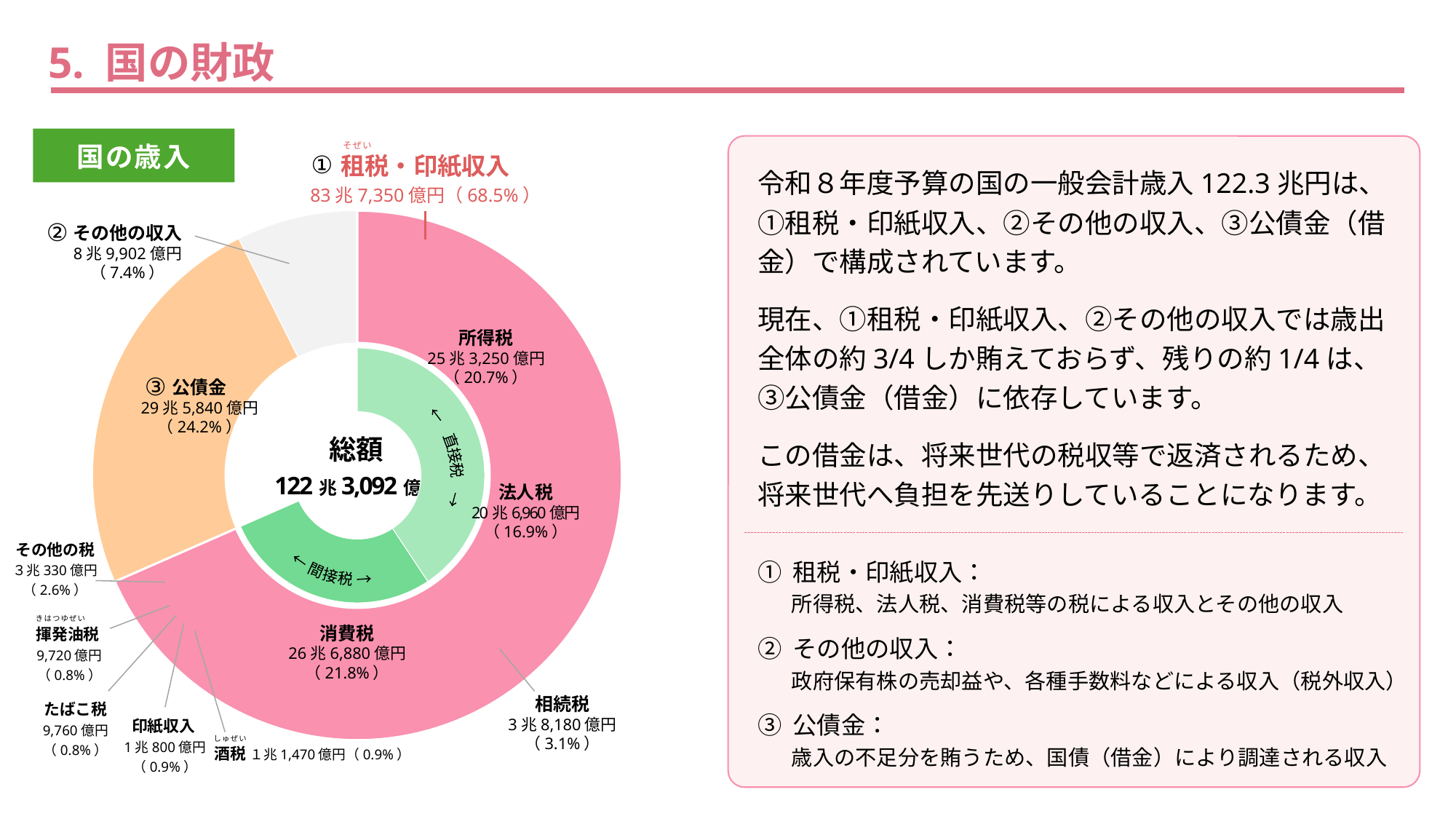
国の歳入のグラフで、所得税の割合と法人税の割合の差は何ポイントですか？ 3.8ポイント 国の歳入のグラフで、相続税の割合は何％ですか？ 3.1% 国の歳入のグラフで、所得税と法人税では、どちらの割合が大きいですか？ 所得税 国の歳入のグラフで、①租税・印紙収入の金額はいくらですか？ 83兆7,350億円 国の歳入のグラフで、③公債金の割合は何％ですか？ 24.2% 国の歳入のグラフで、消費税の金額はいくらですか？ 26兆6,880億円 国の歳入のグラフは、どのような種類のグラフですか？ 円グラフ（ドーナツグラフ） 国の歳入のグラフで、①租税・印紙収入、②その他の収入、③公債金のうち、割合が最も大きいのはどれですか？ ①租税・印紙収入 国の歳入のグラフで、②その他の収入の金額はいくらですか？ 8兆9,902億円 国の歳入のグラフの中央に示されている総額はいくらですか？ 122兆3,092億円 国の歳入のグラフで、①租税・印紙収入、②その他の収入、③公債金のうち、割合が最も小さいのはどれですか？ ②その他の収入 国の歳入のグラフで、内側の輪に示されている2つの区分は何ですか？ 直接税と間接税